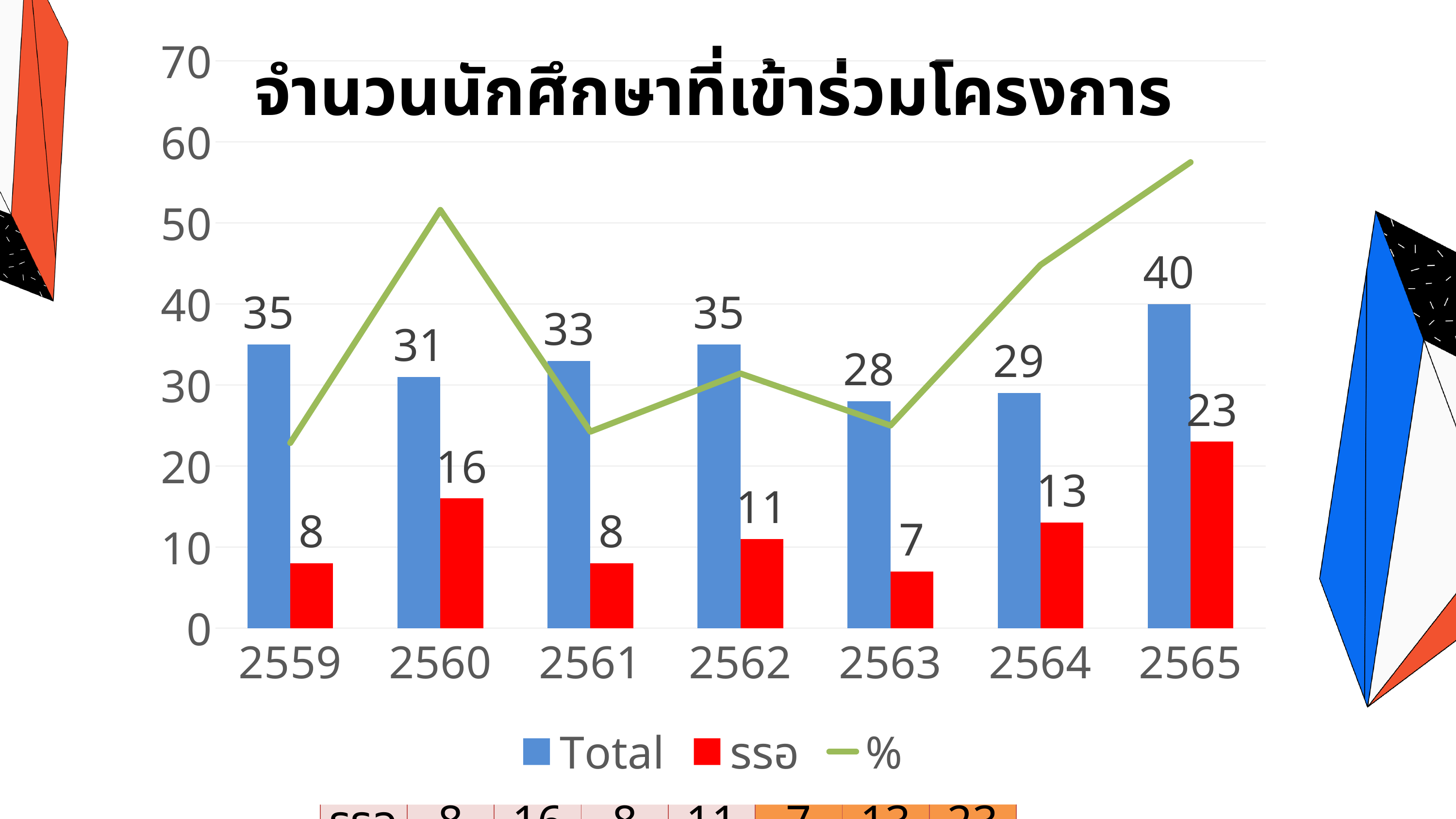
What is the Total value for 2565? 40 Which year has the highest Total value? 2565 How many years are shown on the x axis? 7 What is the difference between the Total and รรอ values in 2565? 17 How many series does the legend list? 3 What colour are the Total bars? Blue Which year has the lowest รรอ value? 2563 Which is larger, the รรอ value for 2564 or the รรอ value for 2562? 2564 What is the รรอ value for 2560? 16 What kind of chart is this? Combined bar and line chart Is the % line value for 2560 greater or less than 40? greater What is the Total value for 2563? 28